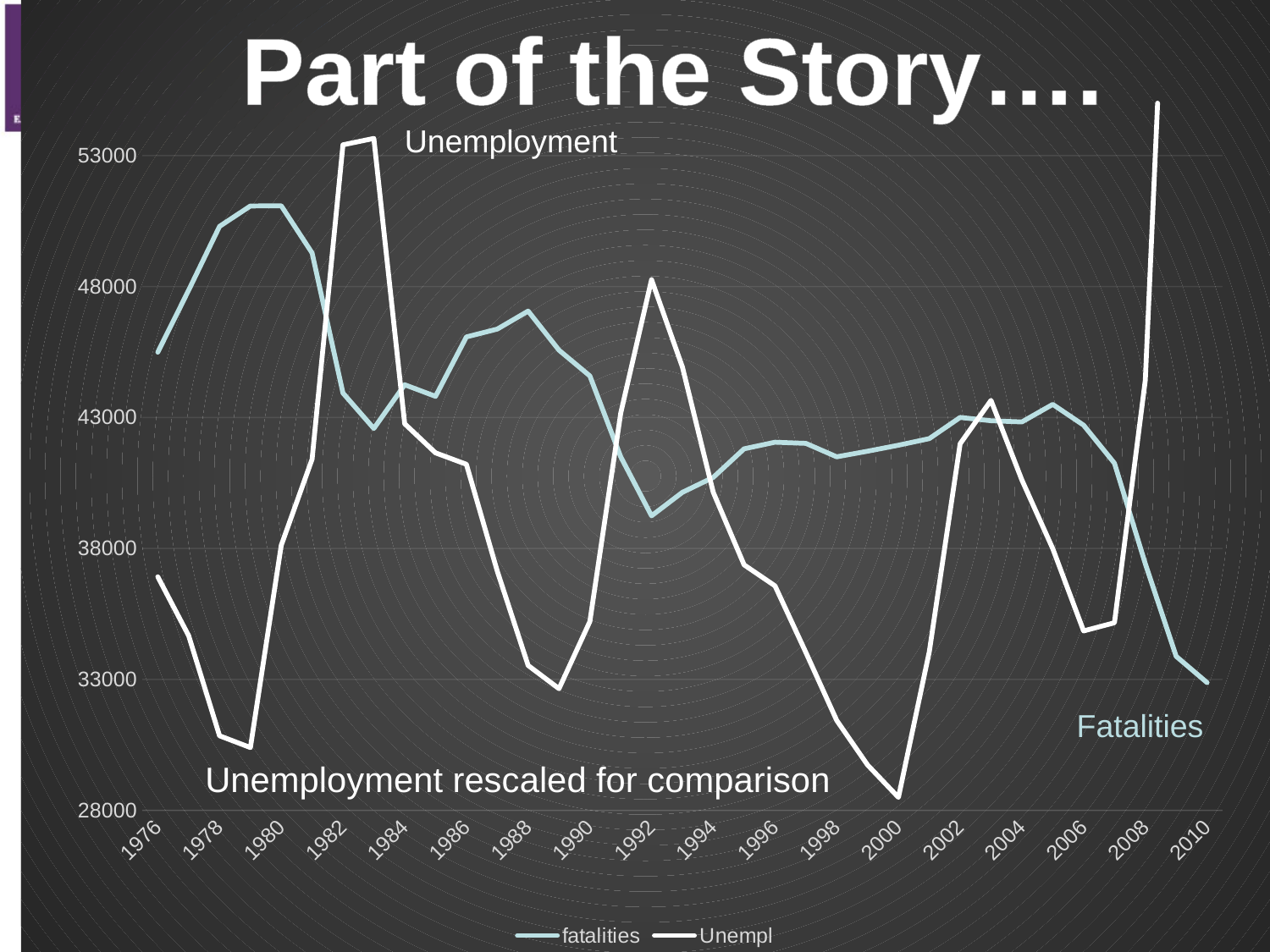
In which year does the fatalities series reach its lowest value? 2010 Does the fatalities series rise or fall between 2006 and 2010? fall Is the fatalities value for 1976 greater or less than 43000? greater Is the Unempl value for 2009 greater or less than 53000? greater How many series does the legend list? 2 Is the Unempl value for 2000 greater or less than 33000? less What kind of chart is shown on the slide? line chart In 1976, which series has the higher value, fatalities or Unempl? fatalities How many year labels are shown along the x axis? 18 What are the two series named in the legend? fatalities and Unempl